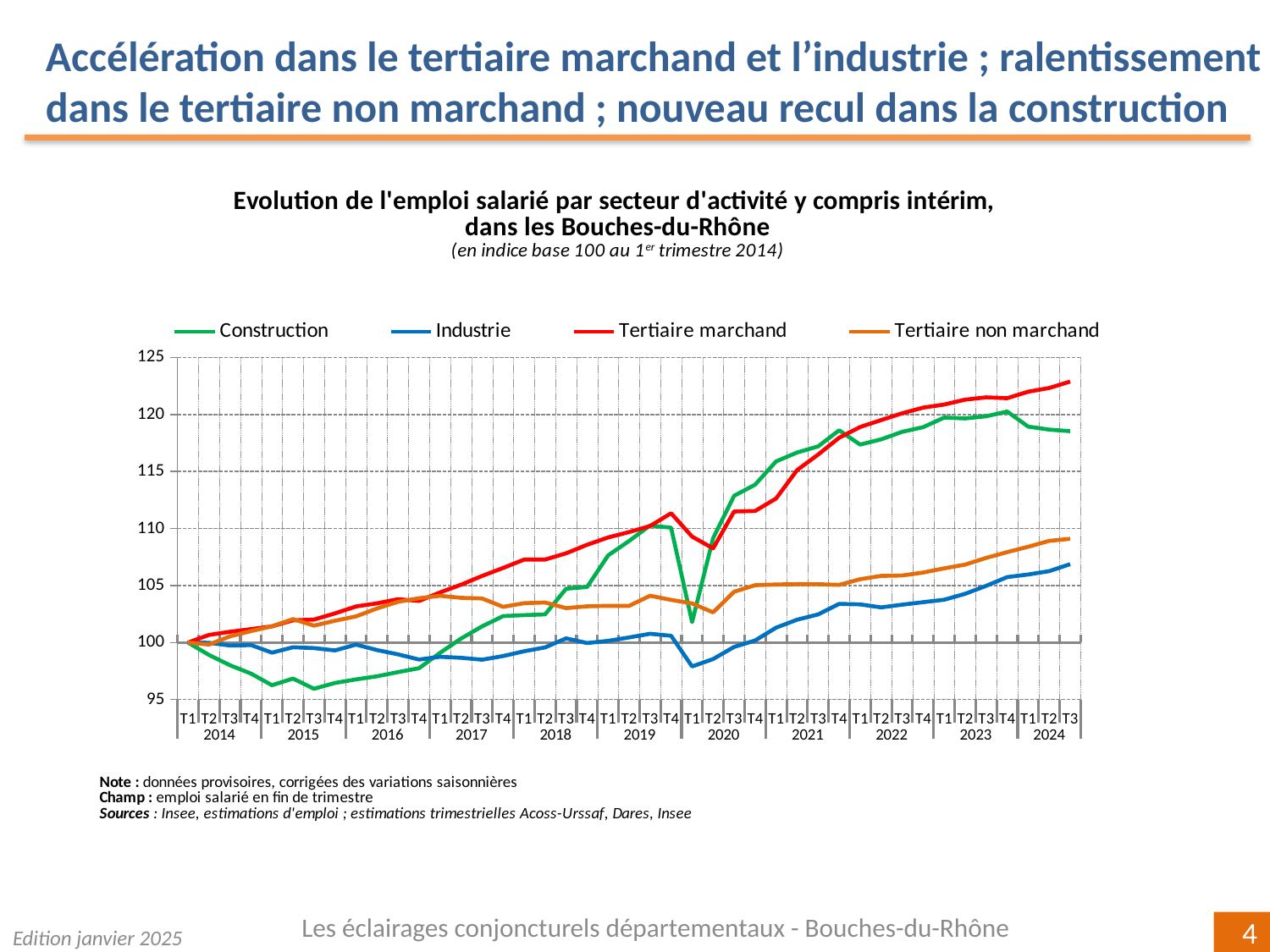
Is the value for Tertiaire non marchand at T3 2024 greater or less than 110? less Is the value for Tertiaire marchand at T3 2024 greater or less than 120? greater How many series does the legend list? 4 What is the index value of all four series at T1 2014? 100 What kind of chart is shown on the slide? line chart Which series has the lowest value at T3 2024? Industrie At T3 2024, which is larger: Construction or Tertiaire non marchand? Construction Is the value for Industrie at T1 2020 greater or less than 100? less Which series has the highest value at T3 2024? Tertiaire marchand How many years are labelled on the x axis? 11 Which series are listed in the legend? Construction, Industrie, Tertiaire marchand, Tertiaire non marchand